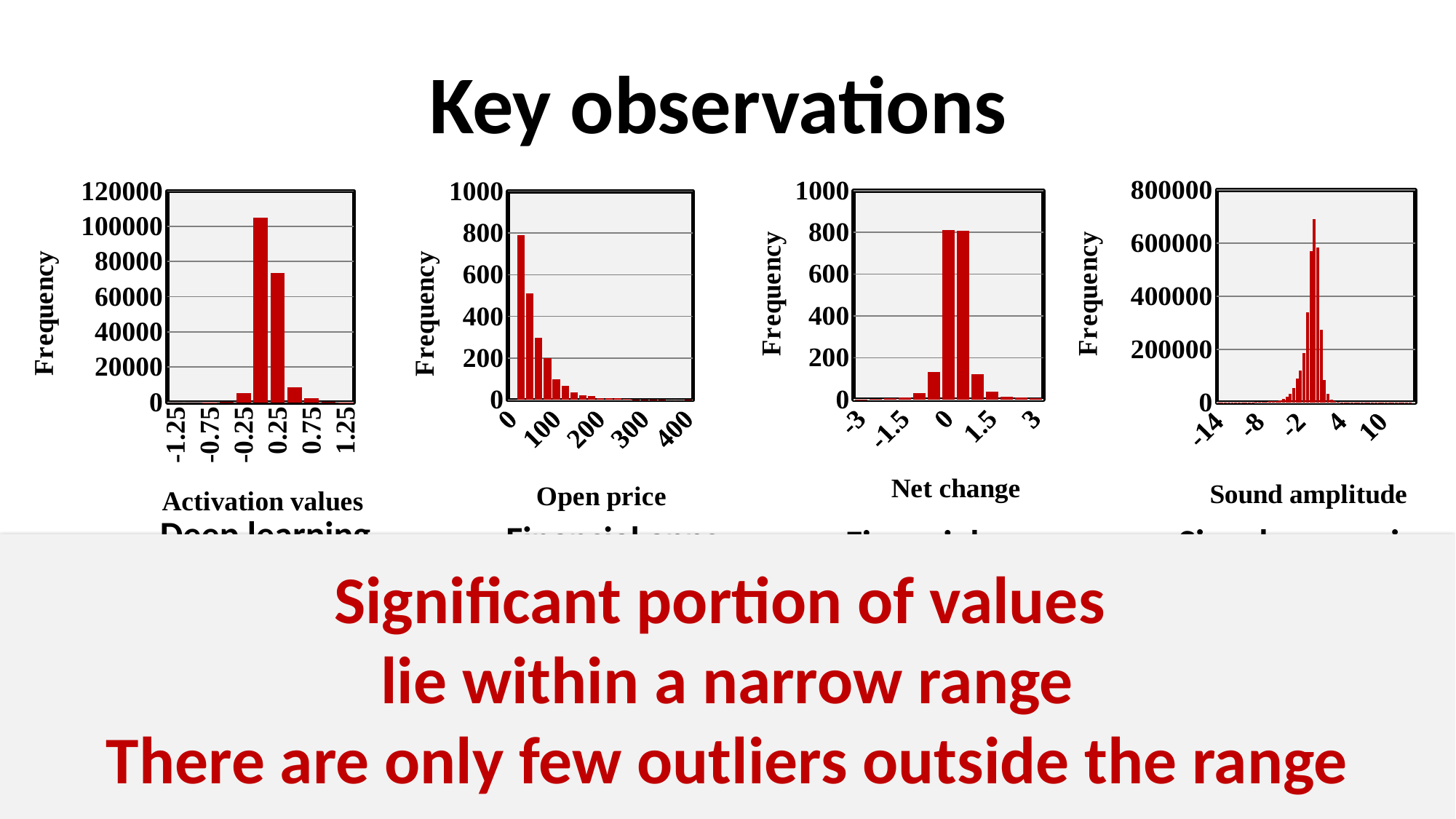
What is the highest y-axis tick value on the Sound amplitude chart? 800000 In the Net change chart, is the bar at -3 greater or less than 200? less In the Open price chart, is the second bar from the left greater or less than 400? greater In the Open price chart, do the bar heights rise or fall as open price increases from 0 to 400? fall In the Net change chart, is the tallest bar greater or less than 600? greater What kind of chart is the Activation values chart? bar chart How many charts are shown on the slide? 4 What is the y-axis label shared by all four charts? Frequency